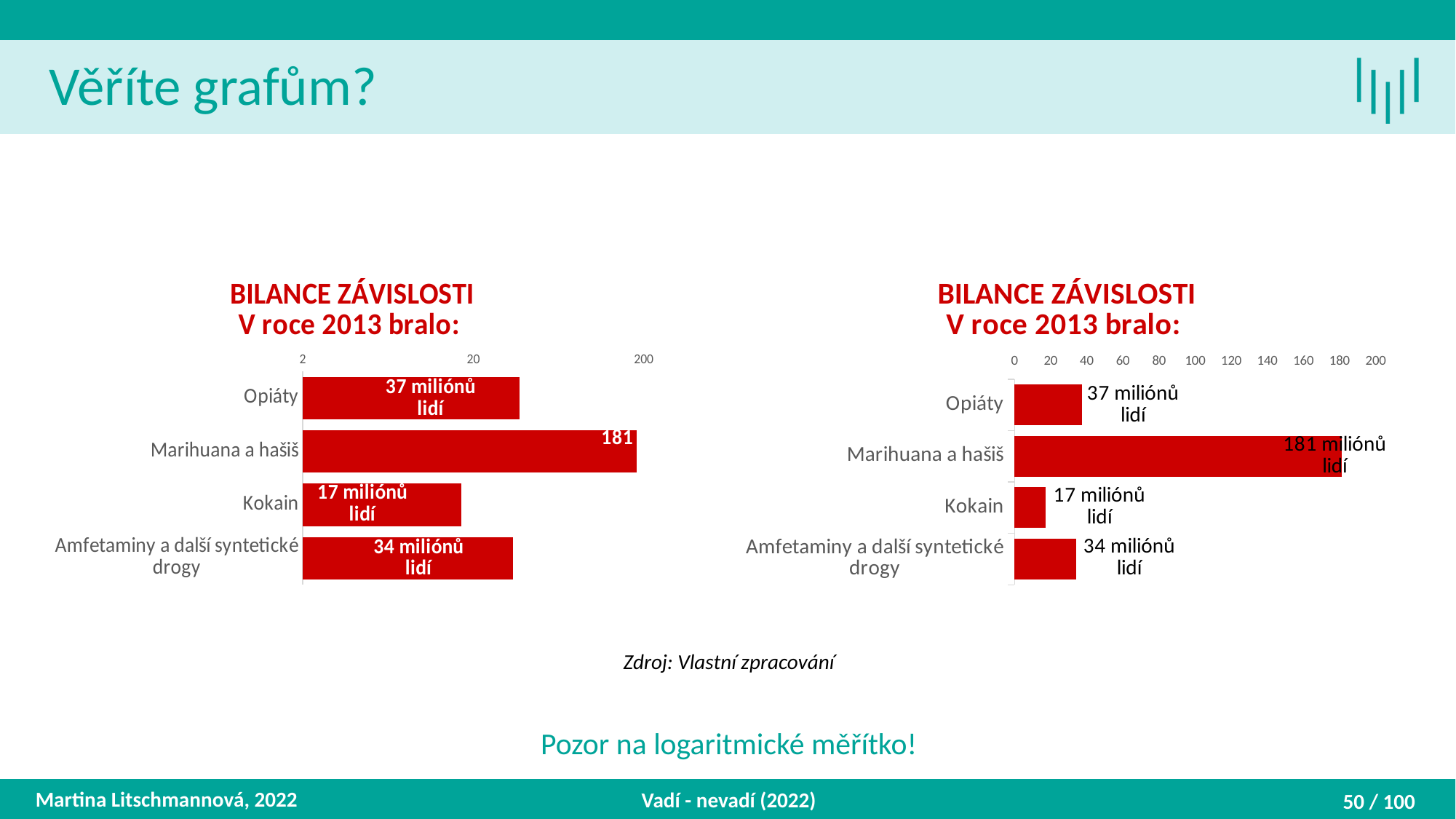
In the left chart, which is larger, the value for Opiáty or the value for Amfetaminy a další syntetické drogy? Opiáty In the right chart, what is the value for Opiáty? 37 miliónů lidí In the right chart, what is the value for Marihuana a hašiš? 181 miliónů lidí What are the axis tick labels shown on the left chart? 2, 20, 200 In the left chart, what is the value for Kokain? 17 miliónů lidí In the right chart, is the value for Marihuana a hašiš greater or less than 160? greater What type of chart is the left chart? bar chart In the right chart, which category has the highest value? Marihuana a hašiš How many categories does the right chart show? 4 In the right chart, what is the difference in millions between Marihuana a hašiš and Opiáty? 144 In the left chart, which category has the lowest value? Kokain In the left chart, what is the value for Amfetaminy a další syntetické drogy? 34 miliónů lidí